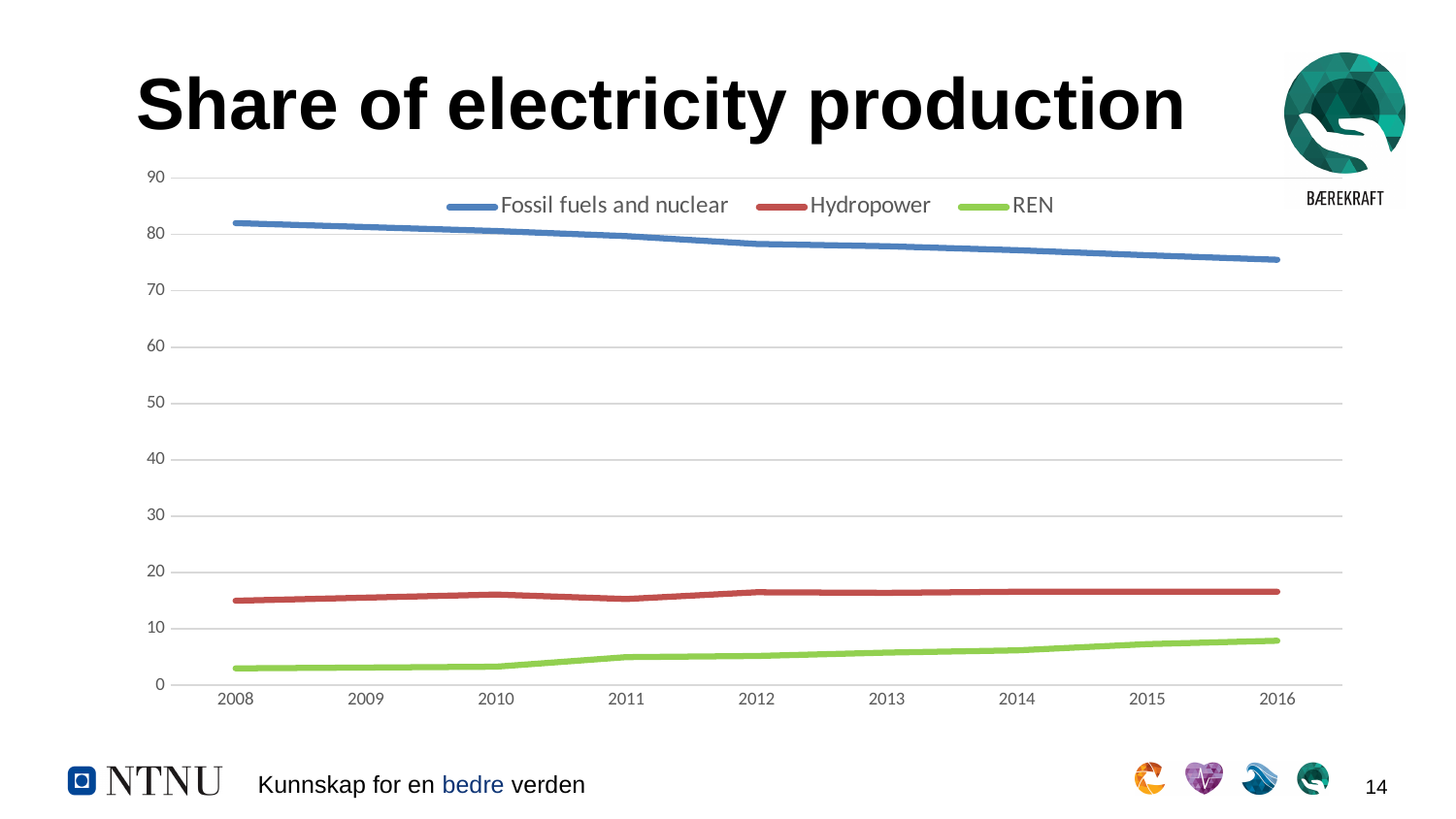
Is the value for REN in 2008 greater or less than 10? less How many years are shown along the x axis? 9 In 2012, which is larger: the share for Hydropower or the share for REN? Hydropower Does the share for REN rise or fall from 2008 to 2016? Rise How many series does the legend list? 3 Which series has the lowest share of electricity production across all years? REN Which series has the highest share of electricity production across all years? Fossil fuels and nuclear Is the value for Fossil fuels and nuclear in 2016 greater or less than 80? less Is the value for Fossil fuels and nuclear in 2008 greater or less than 80? greater What kind of chart is shown on the slide? Line chart What is the title of the chart? Share of electricity production Does the share for Fossil fuels and nuclear rise or fall from 2008 to 2016? Fall